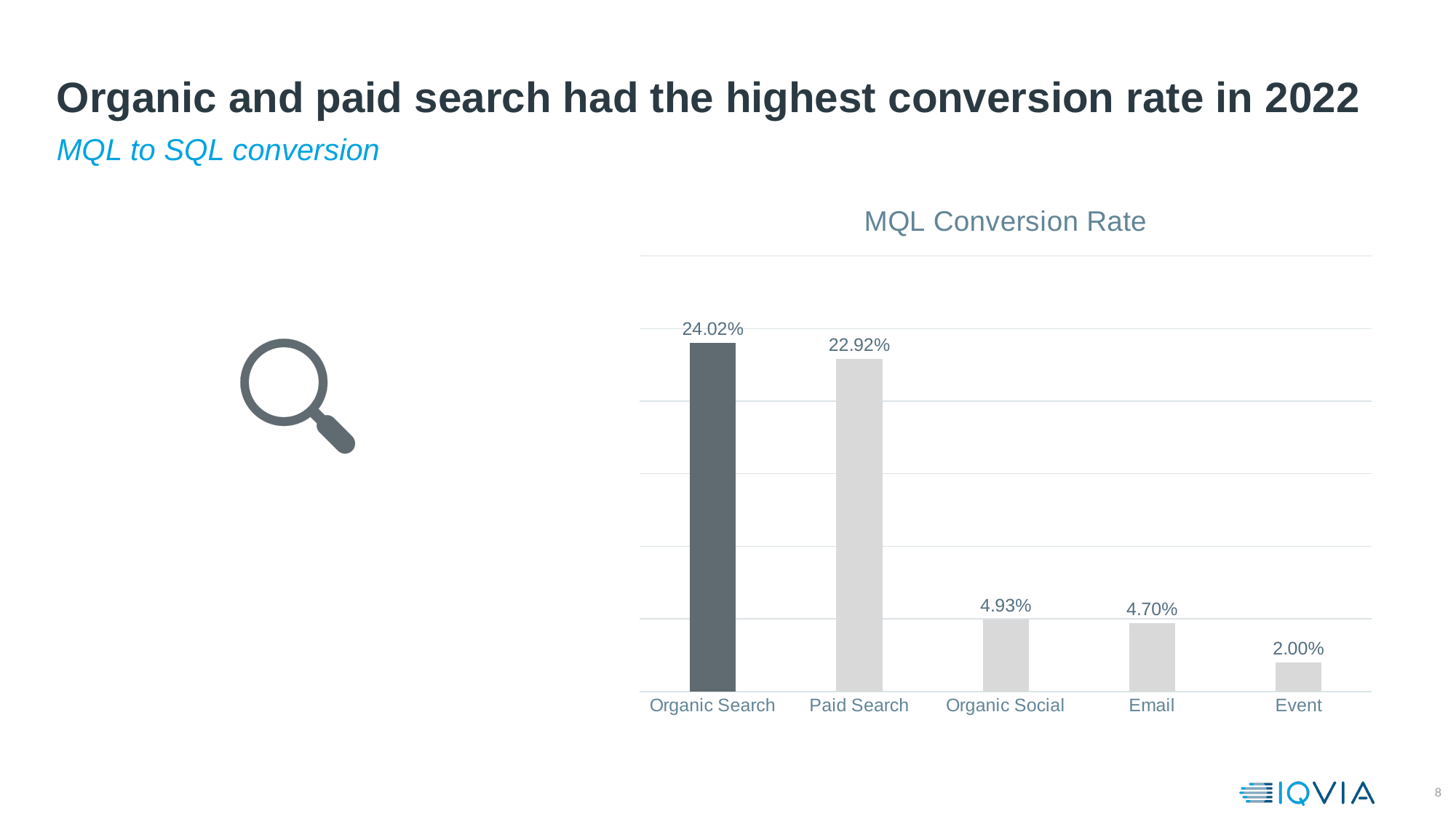
What is the MQL conversion rate for Organic Social? 4.93% How many channels are shown in the MQL Conversion Rate chart? 5 Which channel has the highest MQL conversion rate? Organic Search Which channel has the lowest MQL conversion rate? Event What is the MQL conversion rate for Event? 2.00% What is the title of the chart on the slide? MQL Conversion Rate What is the MQL conversion rate for Email? 4.70% Which has a higher MQL conversion rate, Paid Search or Email? Paid Search What is the MQL conversion rate for Organic Search? 24.02% What is the MQL conversion rate for Paid Search? 22.92% What is the difference in MQL conversion rate between Organic Search and Paid Search? 1.10% What type of chart is used to show the MQL Conversion Rate? Bar chart